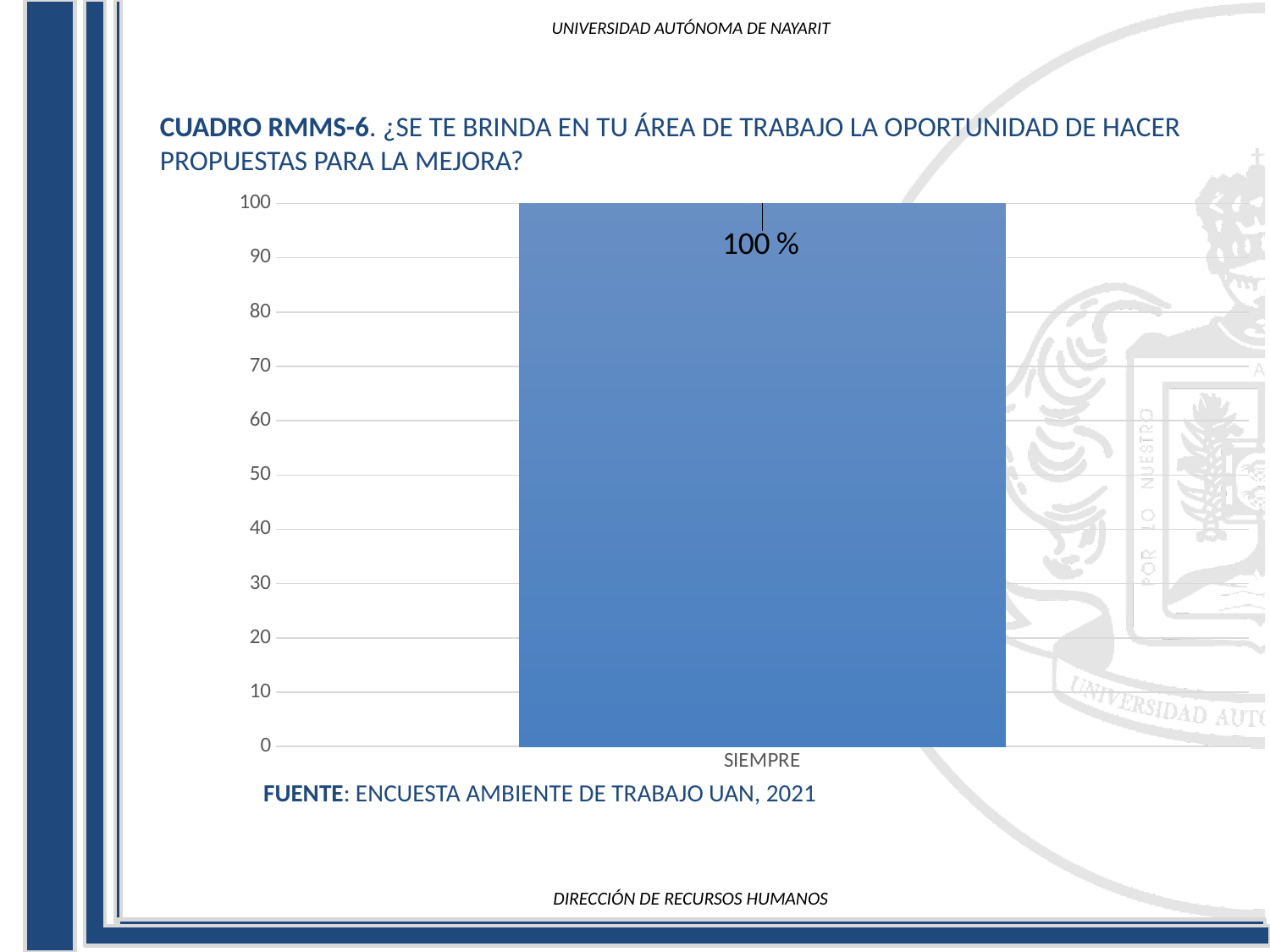
How many categories are plotted on the x axis? 1 What is the label of the only category on the x axis? SIEMPRE What is the highest value shown on the vertical axis? 100 Is the value for SIEMPRE greater or less than 50? greater What kind of chart is shown on the slide? bar chart What is the value shown for SIEMPRE? 100 % Which category has the highest value? SIEMPRE